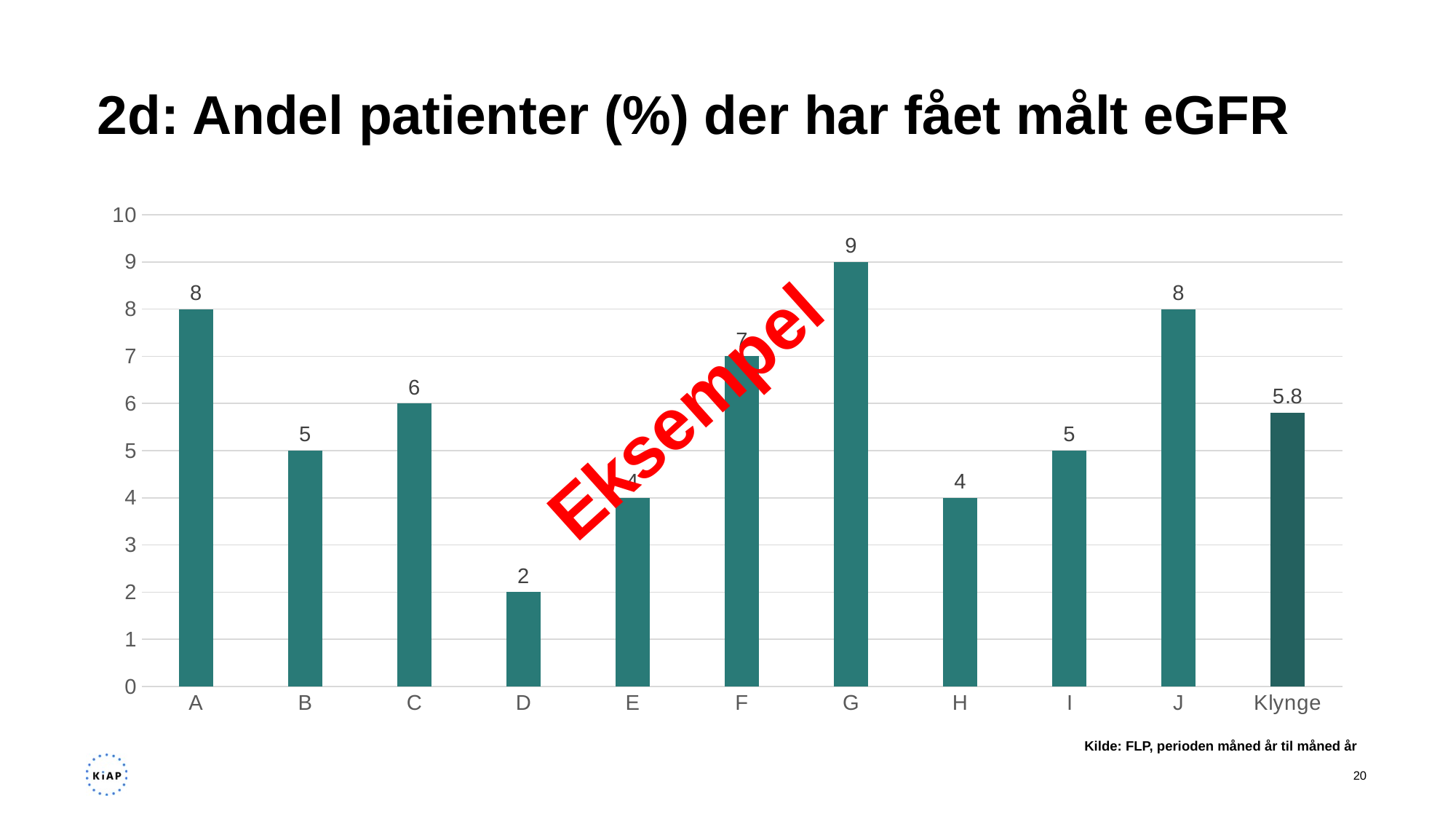
Which category has the highest value? G What is the value for category D? 2 Is the value for Klynge greater or less than 5? greater What kind of chart is shown on the slide? bar chart What is the title of the slide? 2d: Andel patienter (%) der har fået målt eGFR What is the value for Klynge? 5.8 What is the difference between the values for A and B? 3 How many categories are shown on the x axis? 11 Which is larger, the value for C or the value for H? C What is the difference between the values for G and D? 7 What is the value for category G? 9 Which category has the lowest value? D